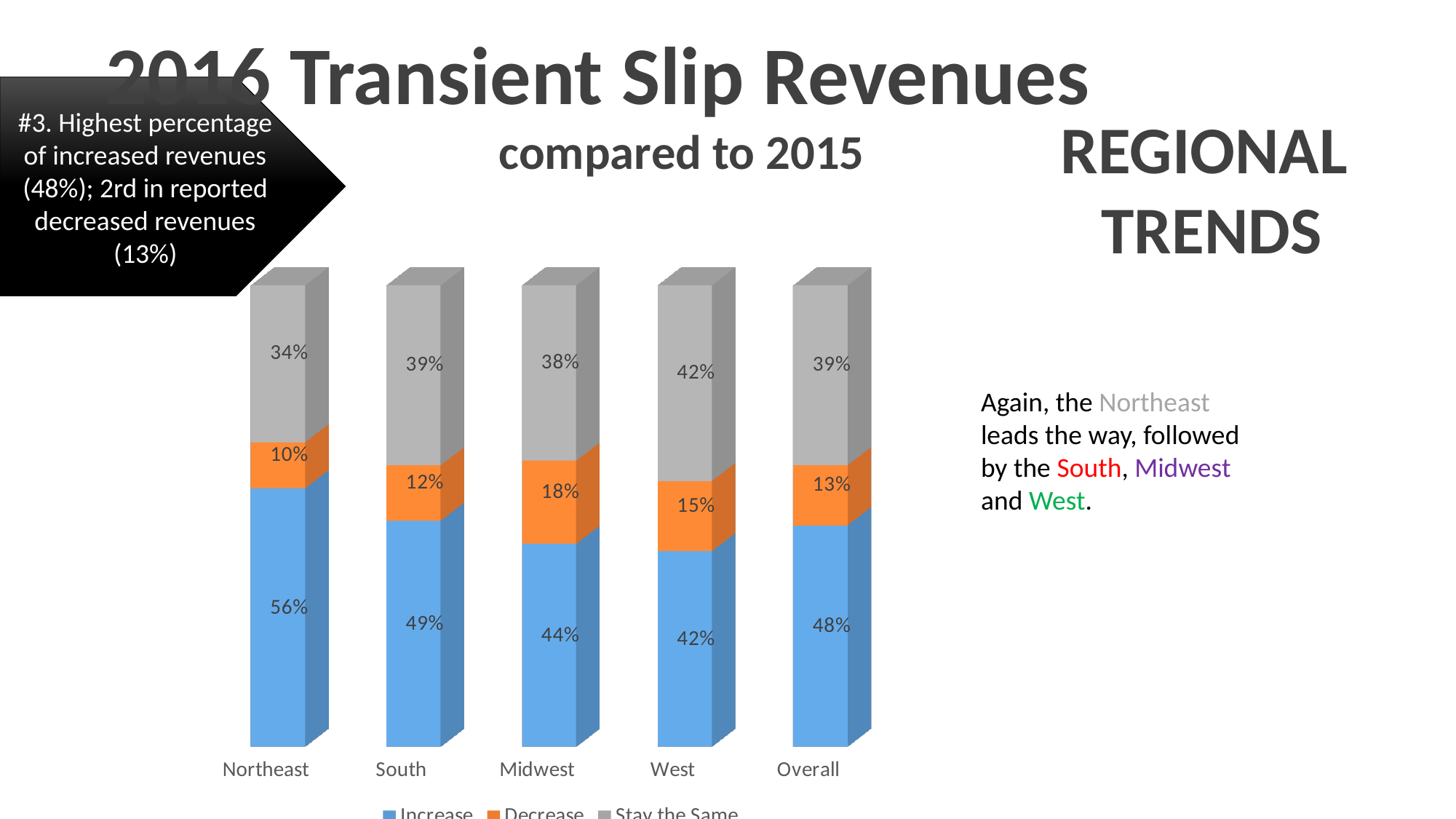
Which region has the lowest Decrease percentage? Northeast Which series is shown in orange? Decrease What percentage of Northeast respondents reported an increase in transient slip revenues? 56% What is the Stay the Same value for the West? 42% Which region has the highest Increase percentage? Northeast Which is larger, the Decrease value for the South or the Decrease value for the Midwest? Midwest What is the Decrease value for the Midwest? 18% What kind of chart is shown on the slide? Stacked bar chart How many series does the legend list? 3 What is the Overall Increase percentage? 48% How many categories are shown on the x axis? 5 What is the difference between the Increase percentages for the Northeast and the West? 14%